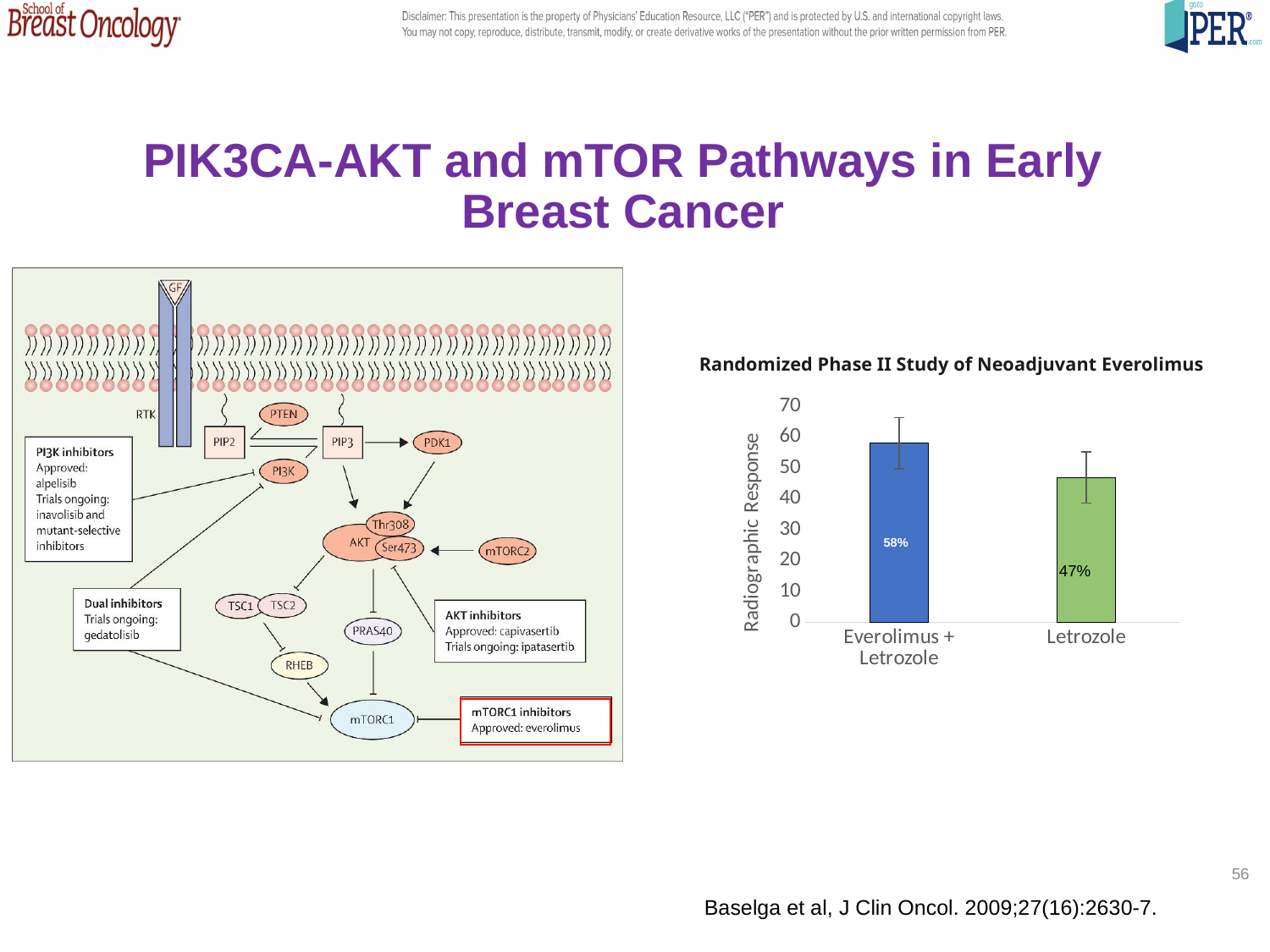
What kind of chart is used to show the radiographic response? Bar chart Is the radiographic response for Letrozole greater or less than 50? less What is the maximum value shown on the y-axis of the chart? 70 Which treatment arm has the lower radiographic response? Letrozole What is the title of the chart? Randomized Phase II Study of Neoadjuvant Everolimus Is the radiographic response for Everolimus + Letrozole greater or less than 50? greater What is the label of the y-axis of the chart? Radiographic Response How many treatment arms are shown in the chart? 2 What is the radiographic response for Letrozole? 47% What is the radiographic response for Everolimus + Letrozole? 58% What is the difference in radiographic response between Everolimus + Letrozole and Letrozole? 11% Which treatment arm has the higher radiographic response? Everolimus + Letrozole